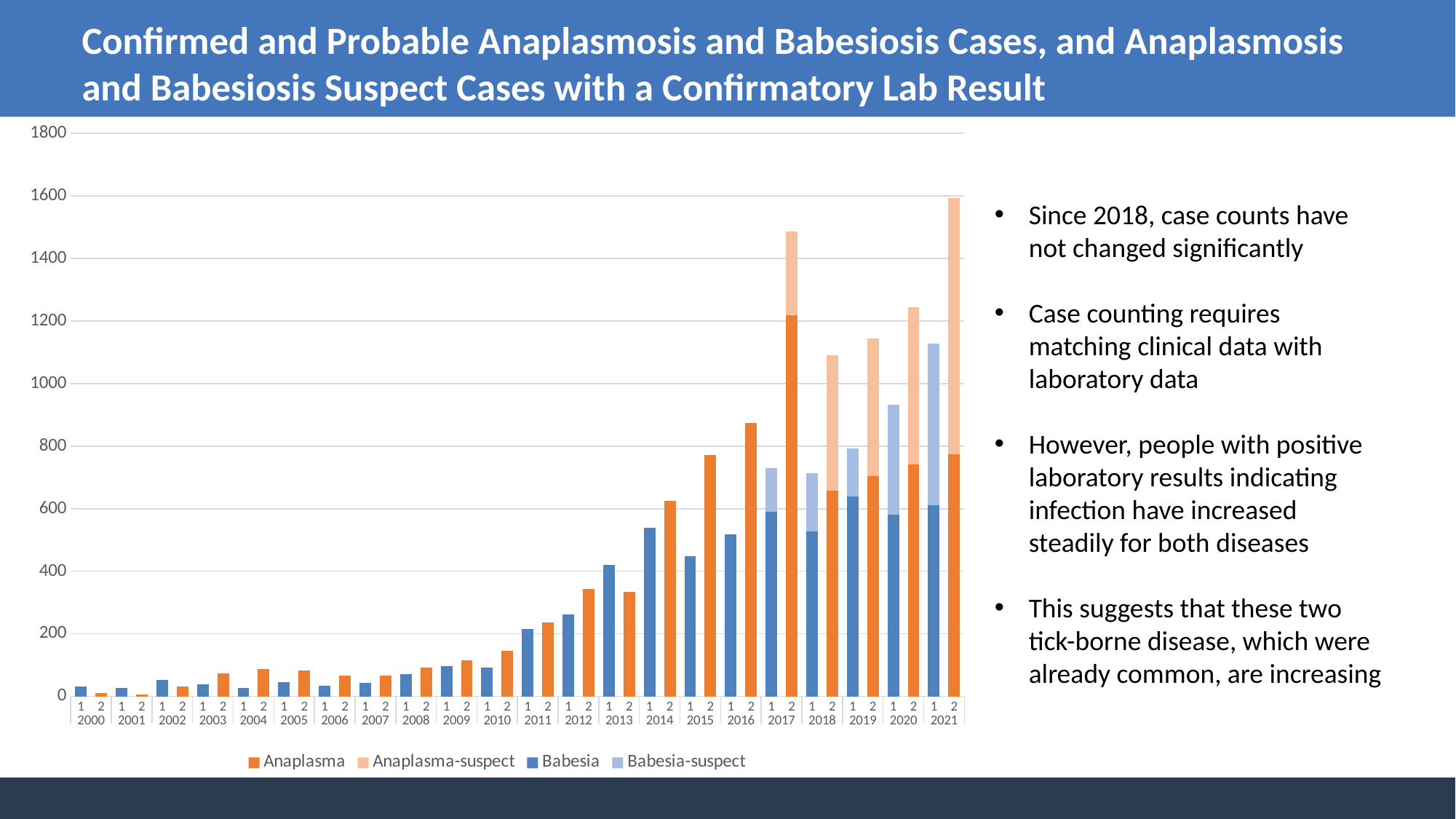
What are the four series named in the legend? Anaplasma, Anaplasma-suspect, Babesia, Babesia-suspect Is the Anaplasma value for 2000 greater or less than 200? less In which year do the suspect-case segments first appear on the bars? 2017 Is the total height of the Babesia stacked bar for 2021 greater or less than 1000? greater How many series does the legend list? 4 Which year has the tallest stacked bar in the chart? 2021 What kind of chart is shown on the slide? Stacked bar chart In 2016, which is larger: the Anaplasma bar or the Babesia bar? Anaplasma Is the total height of the Anaplasma stacked bar for 2021 greater or less than 1400? greater How many years are shown along the x axis? 22 Do the Babesia values generally rise or fall from 2000 to 2021? rise